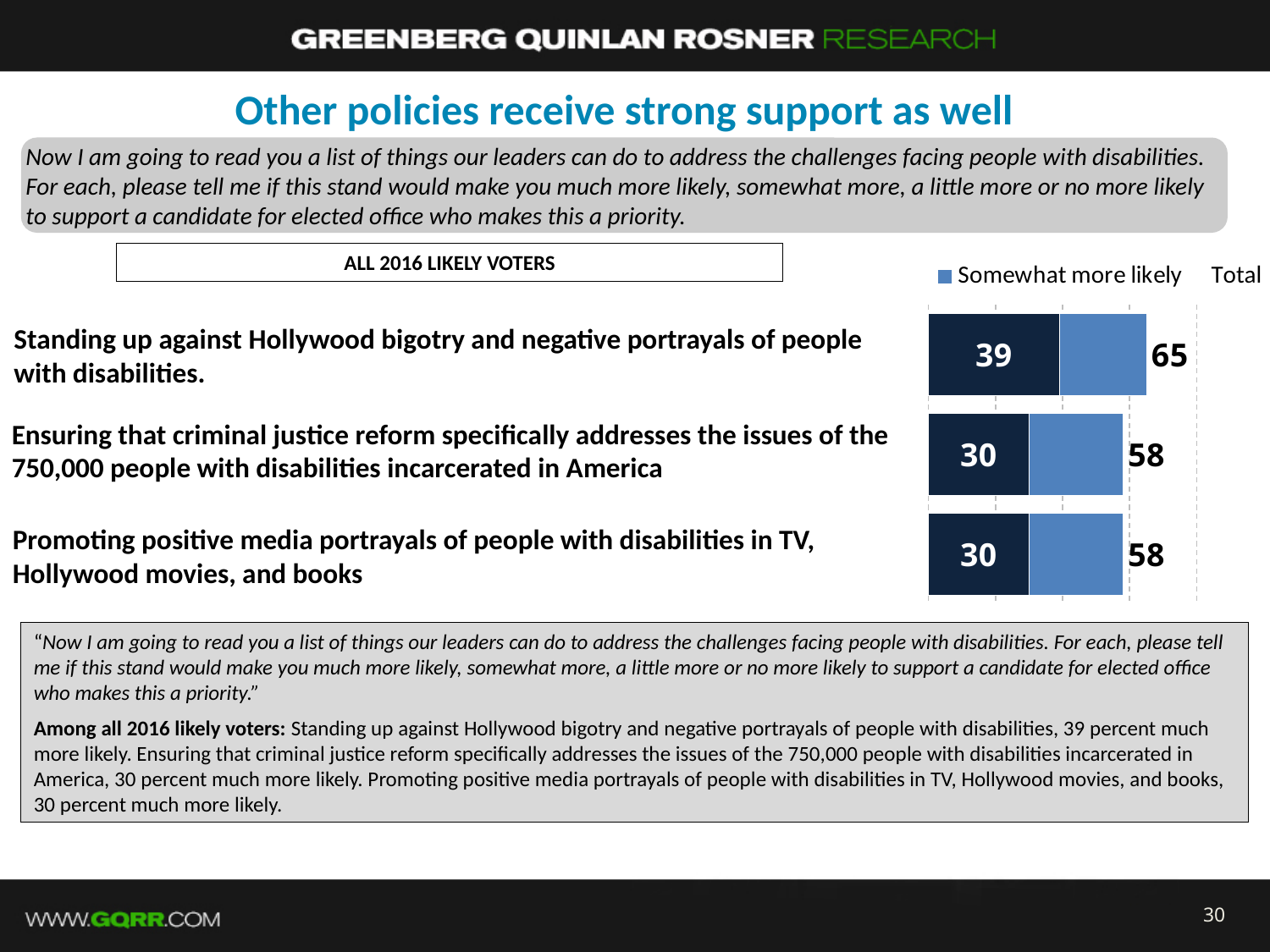
What kind of chart is shown on the slide? stacked bar chart What is the difference between the total (65) and the dark-segment value (39) for 'Standing up against Hollywood bigotry and negative portrayals of people with disabilities'? 26 What is the total value shown for 'Promoting positive media portrayals of people with disabilities in TV, Hollywood movies, and books'? 58 Which policy has the highest total value? Standing up against Hollywood bigotry and negative portrayals of people with disabilities. What is the dark-segment value for 'Ensuring that criminal justice reform specifically addresses the issues of the 750,000 people with disabilities incarcerated in America'? 30 Which policy has the highest dark-segment ('much more likely') value? Standing up against Hollywood bigotry and negative portrayals of people with disabilities. What is the 'much more likely' value (dark segment) for 'Standing up against Hollywood bigotry and negative portrayals of people with disabilities'? 39 Is the dark-segment value for 'Standing up against Hollywood bigotry' larger or smaller than the dark-segment value for 'Promoting positive media portrayals'? larger Which group of respondents does the chart cover, according to the label above it? ALL 2016 LIKELY VOTERS What is the total value shown for 'Ensuring that criminal justice reform specifically addresses the issues of the 750,000 people with disabilities incarcerated in America'? 58 What is the difference between the total for 'Standing up against Hollywood bigotry' and the total for 'Promoting positive media portrayals'? 7 How many policies (bars) are shown in the chart? 3